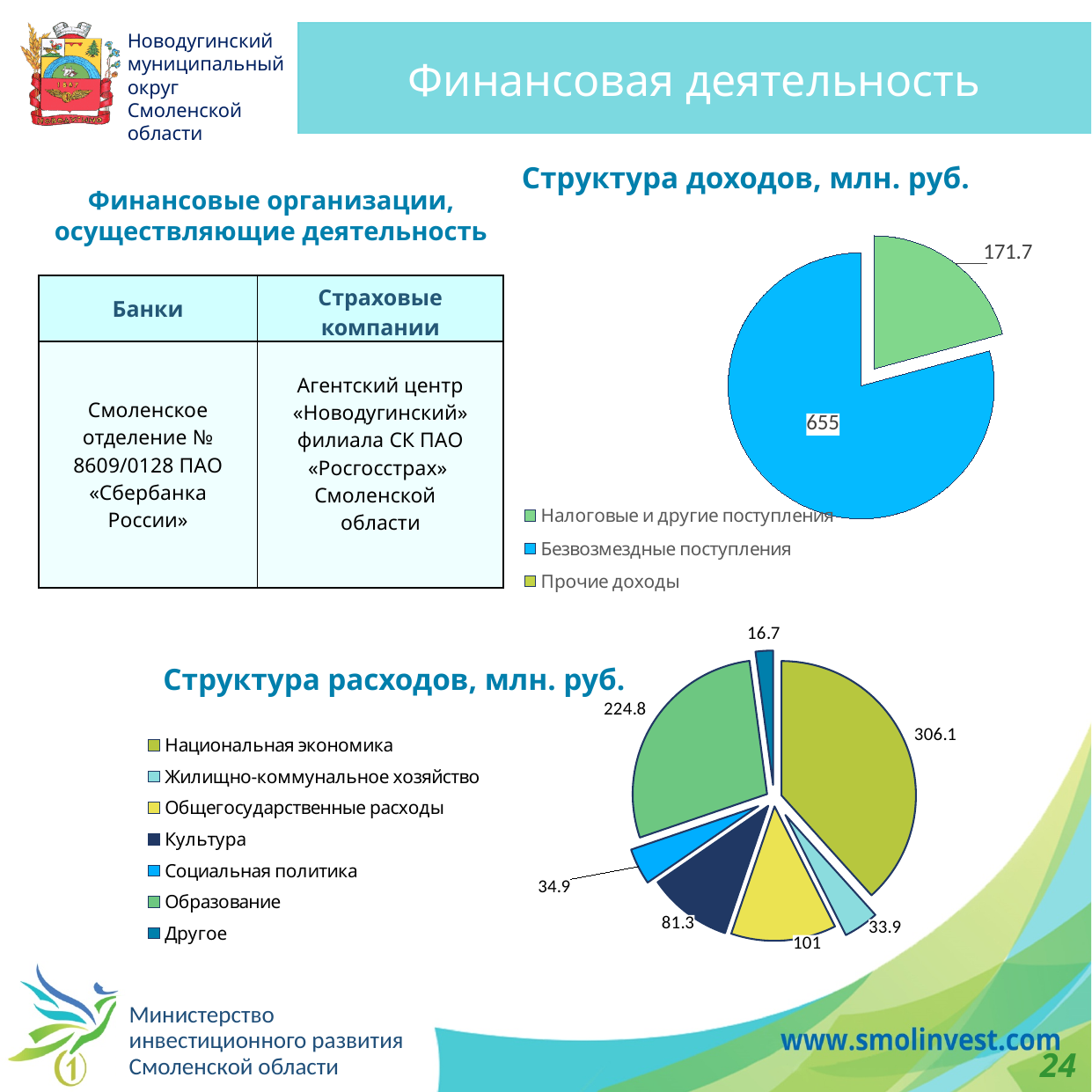
How many categories does the legend of the 'Структура расходов, млн. руб.' chart list? 7 In the 'Структура расходов, млн. руб.' chart, which category has the smallest value? Другое In the 'Структура расходов, млн. руб.' chart, what is the difference between Национальная экономика and Образование? 81.3 What kind of chart is the 'Структура доходов, млн. руб.' chart? pie chart In the 'Структура доходов, млн. руб.' chart, what is the value for Налоговые и другие поступления? 171.7 In the 'Структура расходов, млн. руб.' chart, which is larger: Общегосударственные расходы or Социальная политика? Общегосударственные расходы How many entries does the legend of the 'Структура доходов, млн. руб.' chart list? 3 In the 'Структура доходов, млн. руб.' chart, how much larger is Безвозмездные поступления than Налоговые и другие поступления? 483.3 In the 'Структура расходов, млн. руб.' chart, what is the value for Образование? 224.8 In the 'Структура расходов, млн. руб.' chart, which category has the largest value? Национальная экономика In the 'Структура расходов, млн. руб.' chart, what is the value for Культура? 81.3 In the 'Структура доходов, млн. руб.' chart, what is the value for Безвозмездные поступления? 655